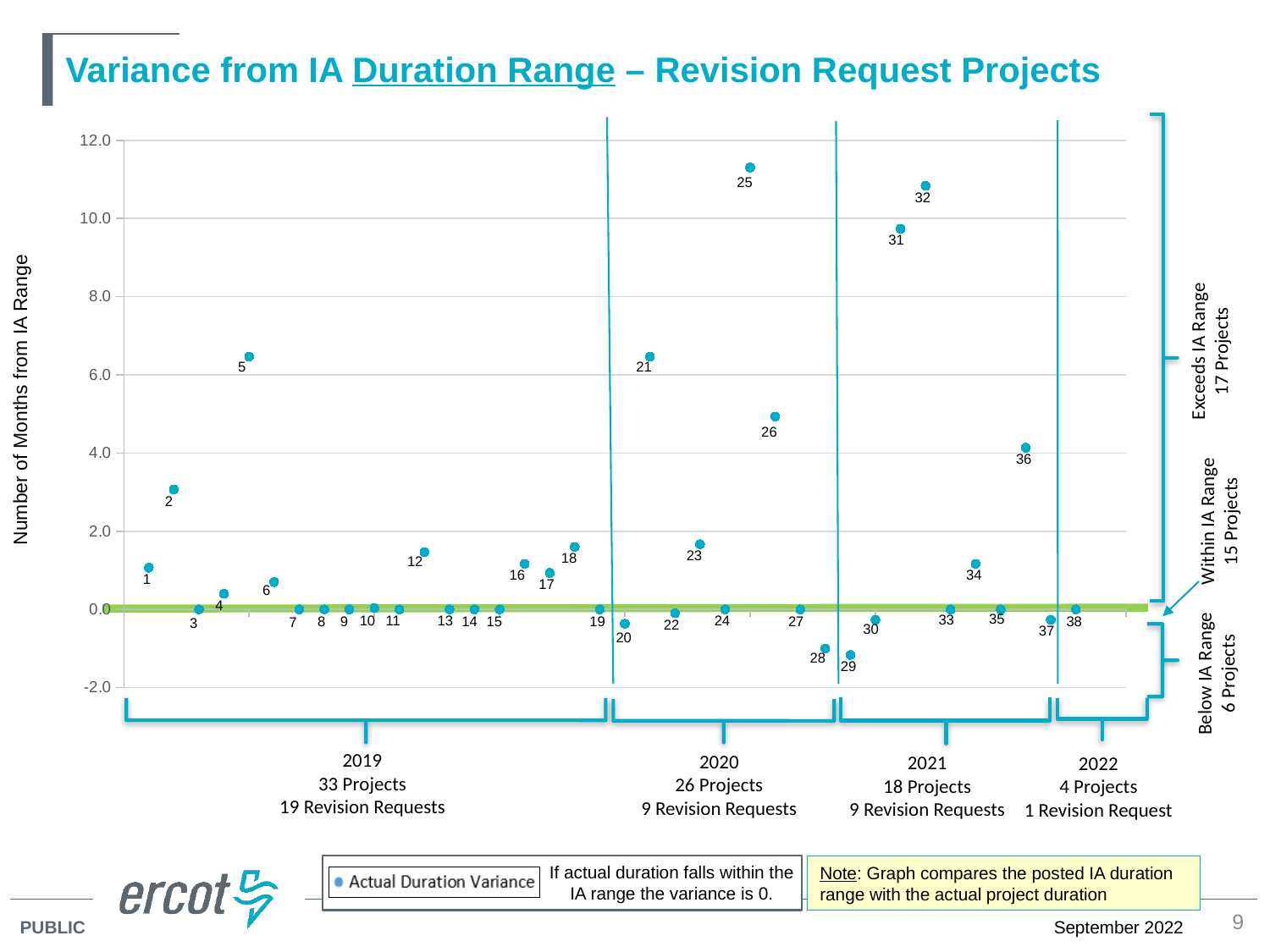
Is the value for point 31 greater or less than 10.0? less Which numbered point has the lowest value on the chart? 29 Which numbered point has the highest value on the chart? 25 What is the title of the vertical axis? Number of Months from IA Range What is the value for point 7? 0.0 Is the value for point 26 greater or less than 6.0? less Which has the higher value, point 31 or point 32? 32 How many numbered points are plotted on the chart? 38 Is the value for point 25 greater or less than 10.0? greater What kind of chart is shown on the slide? scatter chart Which has the higher value, point 2 or point 36? 36